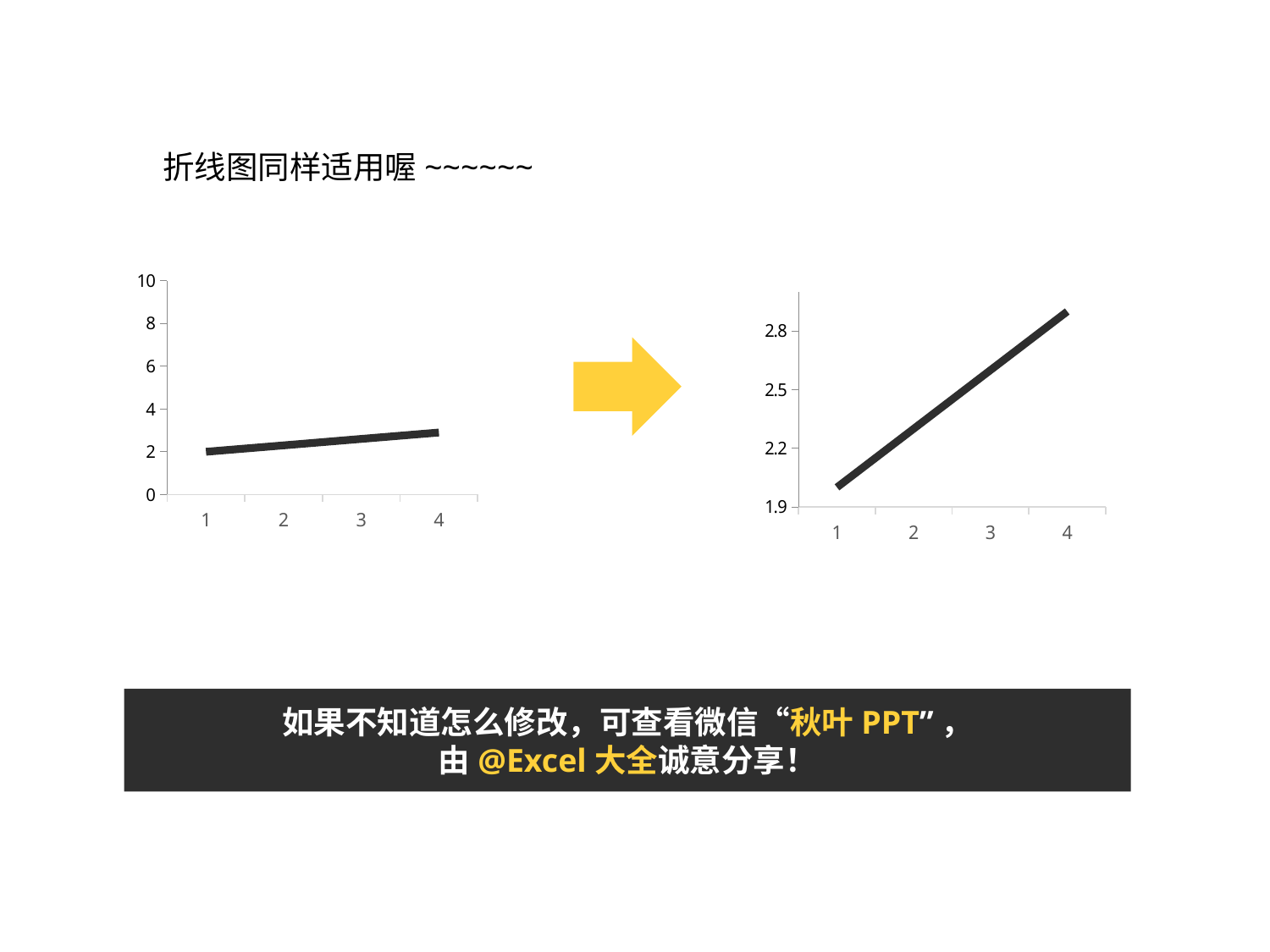
What kind of chart is the chart on the left of the slide? line chart In the right chart, which x-axis category has the highest value? 4 What is the highest value shown on the y axis of the left chart? 10 What kind of chart is the chart on the right of the slide? line chart In the right chart, which x-axis category has the lowest value? 1 In the right chart, is the value at x = 4 greater or less than 2.8? greater How many categories are shown on the x axis of the right chart? 4 In the right chart, do the values rise or fall along the x axis? rise In the left chart, is the value at x = 4 greater or less than 4? less In the left chart, do the values rise or fall from x = 1 to x = 4? rise In the right chart, is the value at x = 2 greater or less than 2.5? less How many points are plotted on the x axis of the left chart? 4